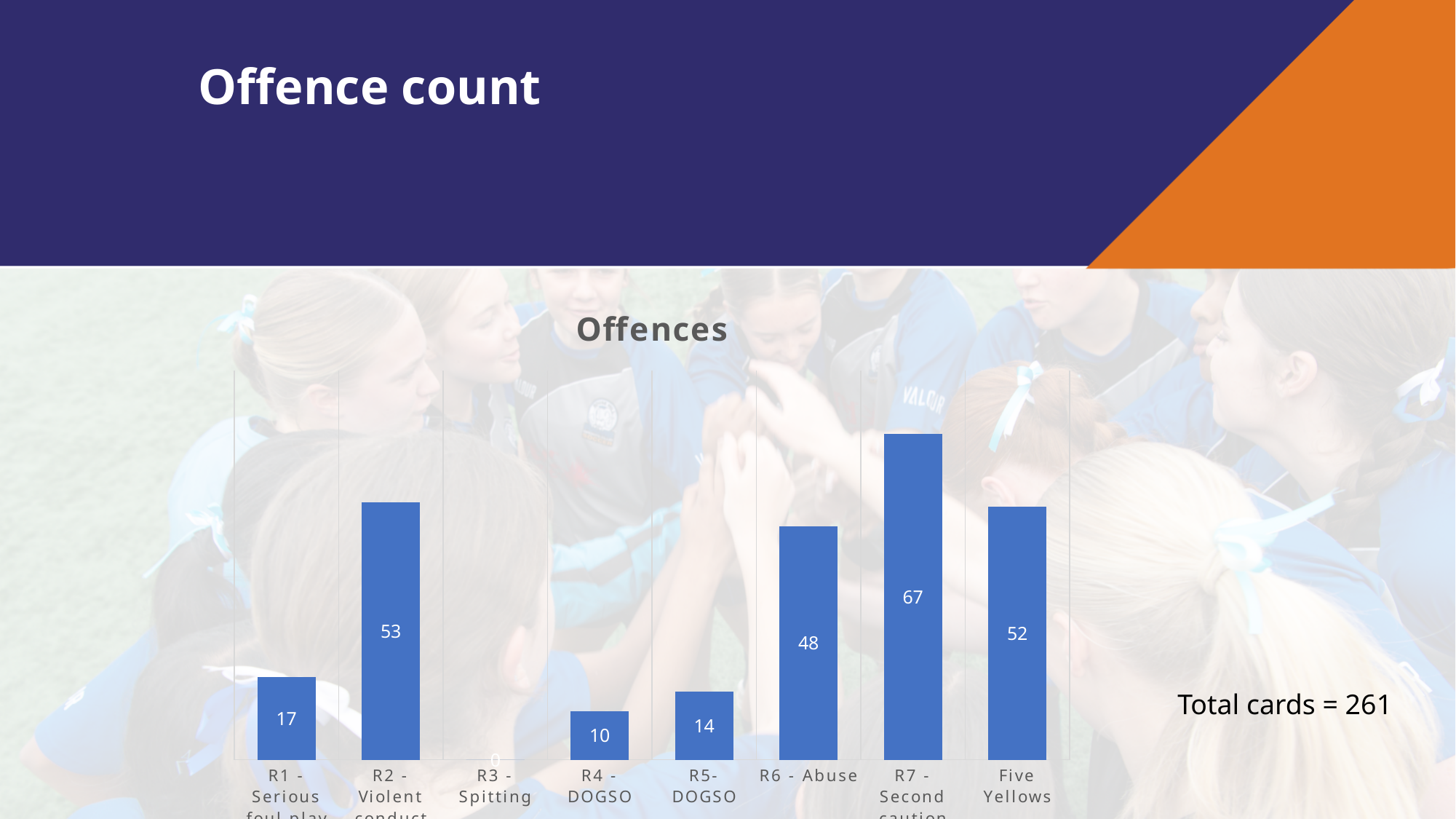
What is the title of the chart on the slide? Offences What is the value for R7 - Second caution in the Offences chart? 67 Which category has the highest value in the Offences chart? R7 - Second caution What is the difference between the values for R5- DOGSO and R4 - DOGSO in the Offences chart? 4 What is the value for R4 - DOGSO in the Offences chart? 10 What kind of chart is the Offences chart? Bar chart What is the difference between the values for R2 - Violent conduct and R1 - Serious foul play in the Offences chart? 36 What is the value for R6 - Abuse in the Offences chart? 48 How many categories are shown in the Offences chart? 8 Which category has the lowest value in the Offences chart? R3 - Spitting What is the value for Five Yellows in the Offences chart? 52 Which is larger in the Offences chart, the value for R6 - Abuse or the value for Five Yellows? Five Yellows